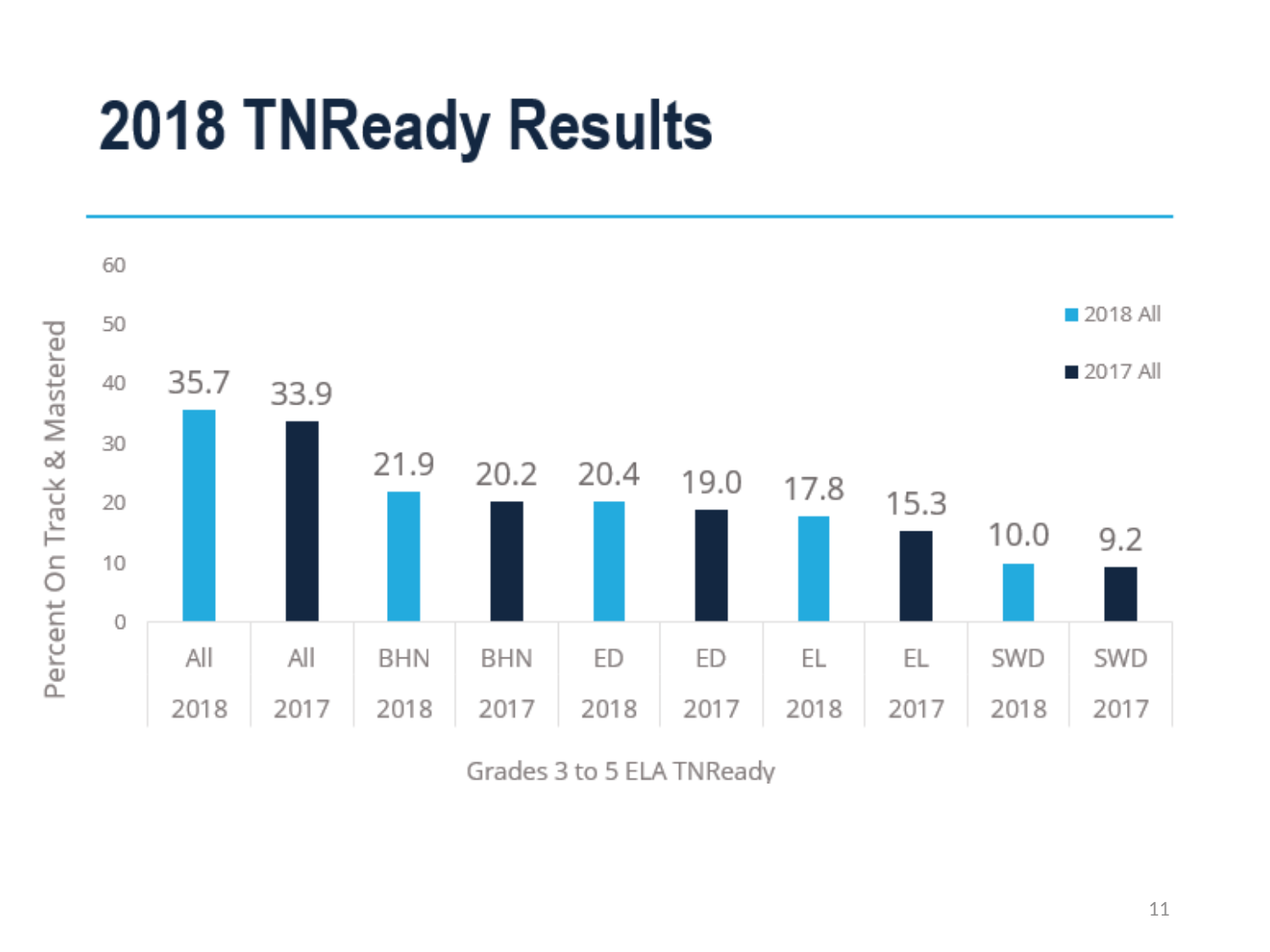
What is the value for All 2018? 35.7 How many series does the legend list? 2 Which bar has the highest value? All 2018 What is the value for EL 2018? 17.8 What is the y-axis label of the chart? Percent On Track & Mastered What is the value for SWD 2017? 9.2 Which is larger, ED 2018 or ED 2017? ED 2018 Which bar has the lowest value? SWD 2017 What kind of chart is shown? Bar chart What is the x-axis label of the chart? Grades 3 to 5 ELA TNReady What is the difference between BHN 2018 and BHN 2017? 1.7 How many bars are plotted in the chart? 10